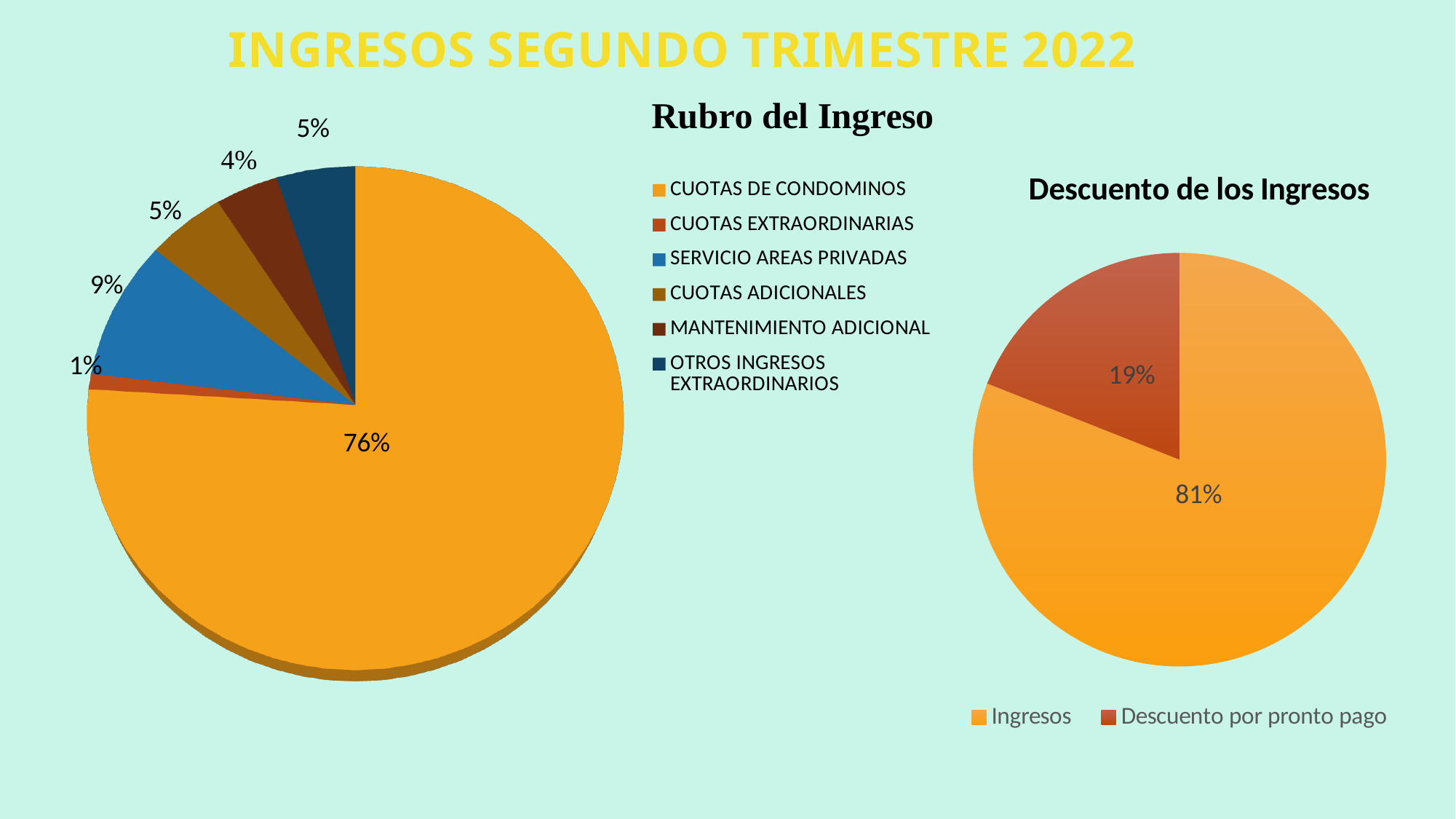
In the 'Descuento de los Ingresos' chart, what share does Ingresos have? 81% In the 'Rubro del Ingreso' chart, which category has the smallest share? CUOTAS EXTRAORDINARIAS In the 'Rubro del Ingreso' chart, what share does MANTENIMIENTO ADICIONAL have? 4% In the 'Rubro del Ingreso' chart, what share does SERVICIO AREAS PRIVADAS have? 9% In the 'Descuento de los Ingresos' chart, which is larger, Ingresos or Descuento por pronto pago? Ingresos In the 'Rubro del Ingreso' chart, which category has the largest share? CUOTAS DE CONDOMINOS In the 'Rubro del Ingreso' chart, how many categories does the legend list? 6 In the 'Rubro del Ingreso' chart, what is the difference in percentage points between SERVICIO AREAS PRIVADAS and MANTENIMIENTO ADICIONAL? 5 percentage points What type of chart is the 'Descuento de los Ingresos' chart? Pie chart